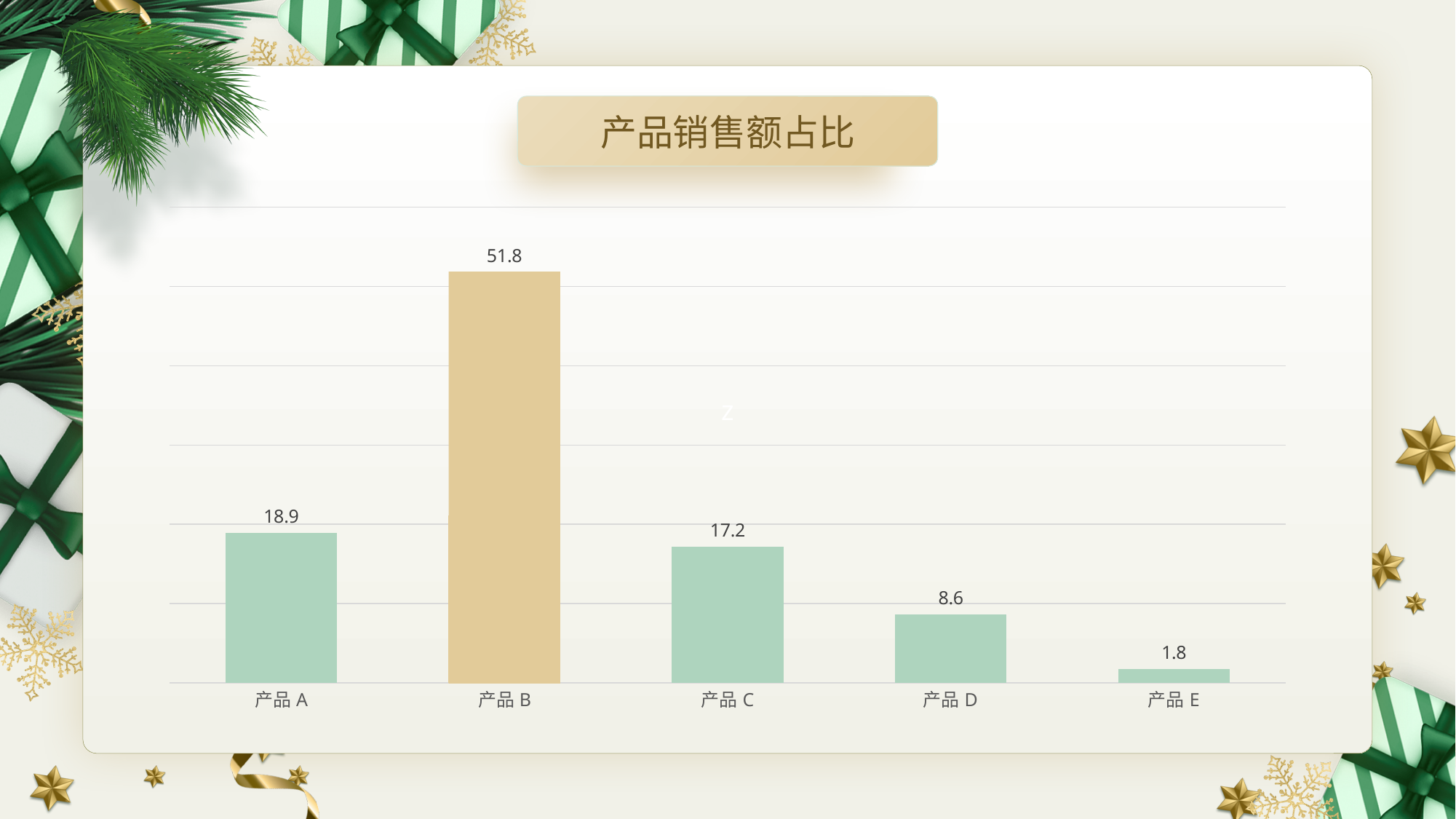
What is the title of the chart? 产品销售额占比 Which is larger, the value for 产品 C or the value for 产品 D? 产品 C What is the value for 产品 A? 18.9 Which product has the highest value? 产品 B What is the value for 产品 E? 1.8 What is the difference between the values for 产品 B and 产品 A? 32.9 What is the value for 产品 C? 17.2 What kind of chart is shown on the slide? Bar chart What is the value for 产品 B? 51.8 What is the value for 产品 D? 8.6 Which product has the lowest value? 产品 E How many products are shown in the chart? 5